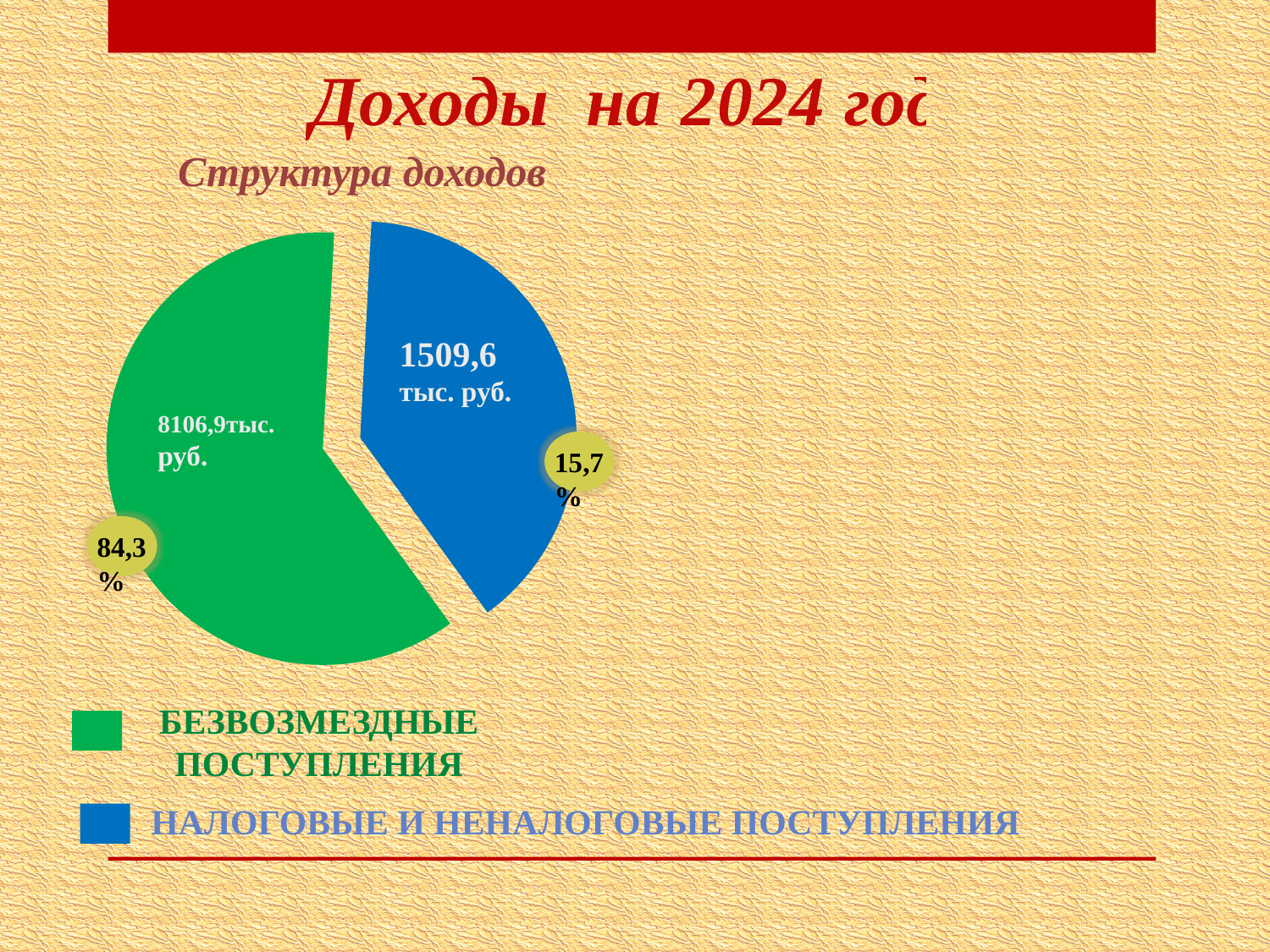
What kind of chart is shown on the slide? Pie chart What is the difference in value between БЕЗВОЗМЕЗДНЫЕ ПОСТУПЛЕНИЯ and НАЛОГОВЫЕ И НЕНАЛОГОВЫЕ ПОСТУПЛЕНИЯ? 6597,3 тыс. руб. What is the value for БЕЗВОЗМЕЗДНЫЕ ПОСТУПЛЕНИЯ? 8106,9 тыс. руб. What share of the pie does БЕЗВОЗМЕЗДНЫЕ ПОСТУПЛЕНИЯ represent? 84,3% What is the value for НАЛОГОВЫЕ И НЕНАЛОГОВЫЕ ПОСТУПЛЕНИЯ? 1509,6 тыс. руб. Which colour represents НАЛОГОВЫЕ И НЕНАЛОГОВЫЕ ПОСТУПЛЕНИЯ in the pie chart? Blue What is the title of the pie chart? Структура доходов Which is larger: БЕЗВОЗМЕЗДНЫЕ ПОСТУПЛЕНИЯ or НАЛОГОВЫЕ И НЕНАЛОГОВЫЕ ПОСТУПЛЕНИЯ? БЕЗВОЗМЕЗДНЫЕ ПОСТУПЛЕНИЯ Which category has the largest slice of the pie? БЕЗВОЗМЕЗДНЫЕ ПОСТУПЛЕНИЯ What share of the pie does НАЛОГОВЫЕ И НЕНАЛОГОВЫЕ ПОСТУПЛЕНИЯ represent? 15,7% How many slices does the pie chart have? 2 Which category has the smallest slice of the pie? НАЛОГОВЫЕ И НЕНАЛОГОВЫЕ ПОСТУПЛЕНИЯ